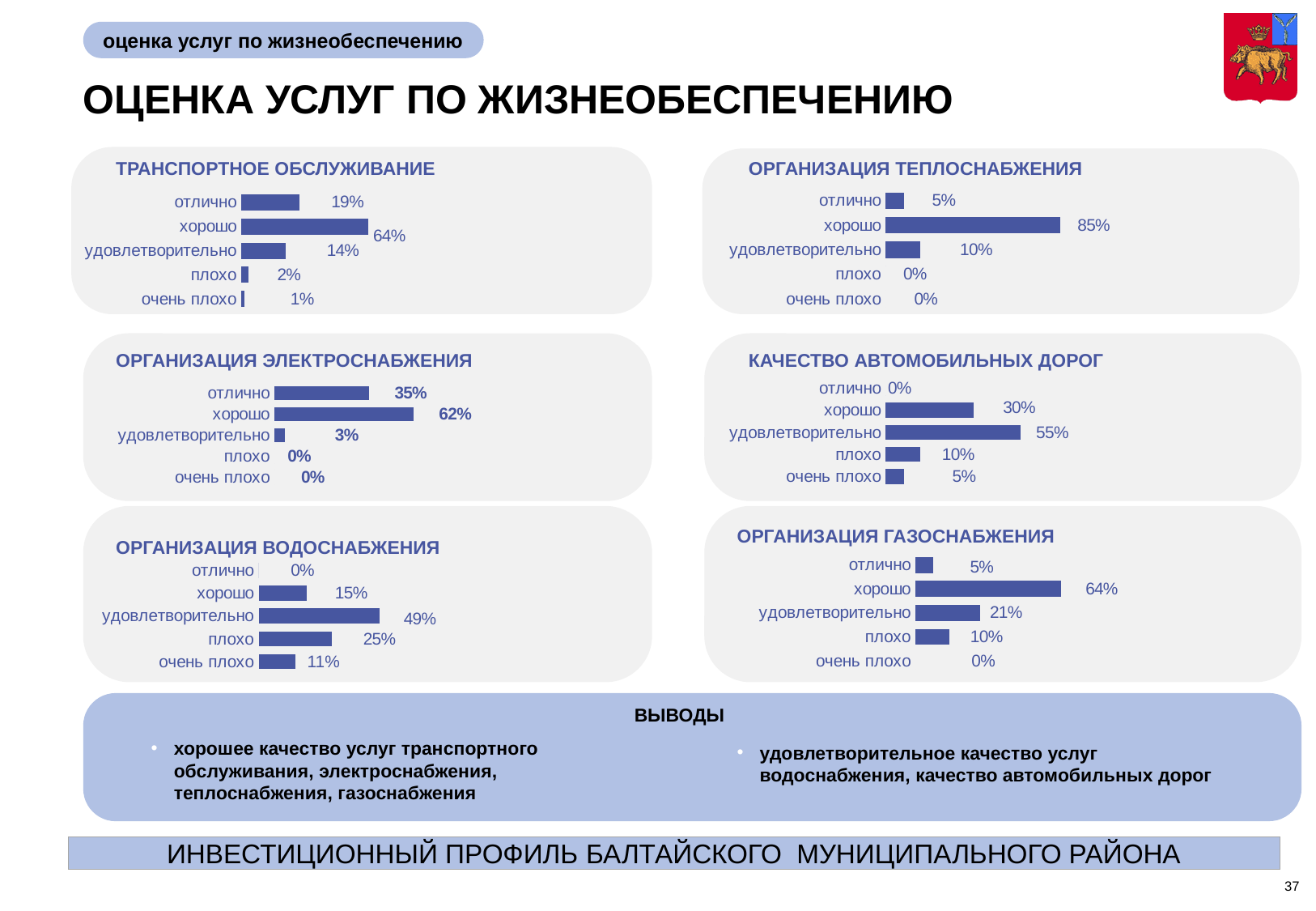
In the "ОРГАНИЗАЦИЯ ВОДОСНАБЖЕНИЯ" chart, which is larger: "хорошо" or "плохо"? плохо How many charts are shown on the slide? 6 In the "ОРГАНИЗАЦИЯ ЭЛЕКТРОСНАБЖЕНИЯ" chart, what is the value for "отлично"? 35% In the "ТРАНСПОРТНОЕ ОБСЛУЖИВАНИЕ" chart, what is the value for "хорошо"? 64% In the "ОРГАНИЗАЦИЯ ГАЗОСНАБЖЕНИЯ" chart, what is the value for "удовлетворительно"? 21% In the "ОРГАНИЗАЦИЯ ТЕПЛОСНАБЖЕНИЯ" chart, which category has the highest value? хорошо In the "ТРАНСПОРТНОЕ ОБСЛУЖИВАНИЕ" chart, which category has the lowest value? очень плохо In the "ОРГАНИЗАЦИЯ ЭЛЕКТРОСНАБЖЕНИЯ" chart, what is the difference between "хорошо" and "отлично"? 27% In the "КАЧЕСТВО АВТОМОБИЛЬНЫХ ДОРОГ" chart, which category has the highest value? удовлетворительно How many categories does the "КАЧЕСТВО АВТОМОБИЛЬНЫХ ДОРОГ" chart show? 5 What type of chart is used for "ОРГАНИЗАЦИЯ ТЕПЛОСНАБЖЕНИЯ"? bar chart In the "ОРГАНИЗАЦИЯ ВОДОСНАБЖЕНИЯ" chart, what is the difference between "удовлетворительно" and "плохо"? 24%